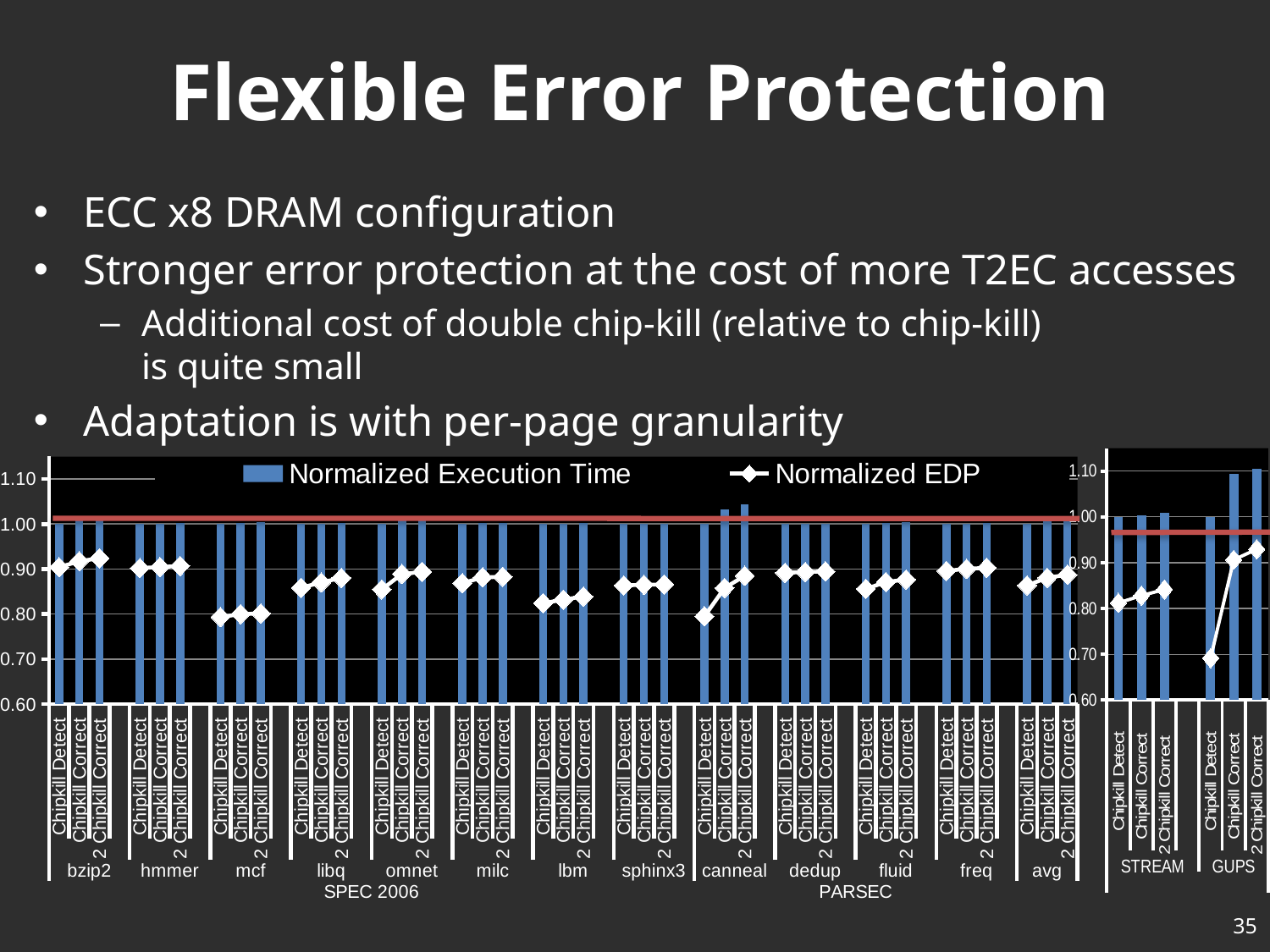
In the right chart, does the Normalized EDP for GUPS rise or fall going from Chipkill Detect to 2 Chipkill Correct? rise In the right chart, is the Normalized EDP value for GUPS Chipkill Detect greater or less than 0.80? less In the right chart, which has the larger Normalized EDP value: GUPS Chipkill Detect or GUPS 2 Chipkill Correct? GUPS 2 Chipkill Correct How many series does the legend of the left chart list? 2 In the left chart, which series is drawn as bars? Normalized Execution Time In the left chart, which series is drawn as a line with diamond markers? Normalized EDP In the right chart, is the Normalized Execution Time bar for GUPS 2 Chipkill Correct greater or less than 1.00? greater What kind of chart is the large chart on the left of the slide? A combined bar and line chart How many benchmark groups (including avg) are shown along the x axis of the left chart? 13 In the left chart, is the Normalized EDP value for lbm Chipkill Detect greater or less than 0.90? less How many benchmarks are shown in the small chart on the right? 2